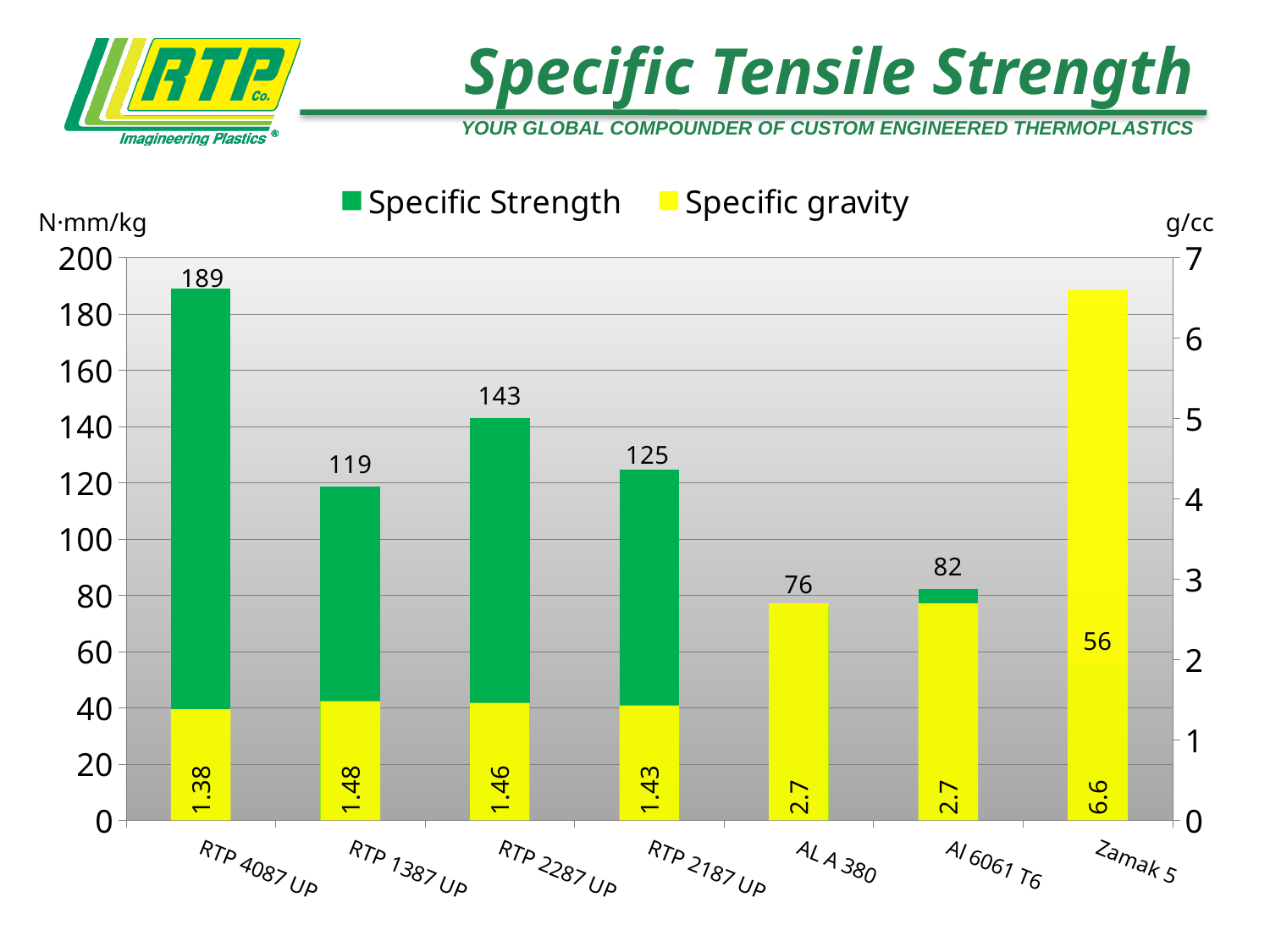
What is the Specific gravity value for Zamak 5? 6.6 What type of chart is shown on the slide? Bar chart How many categories are shown on the x axis? 7 What is the difference in Specific Strength between RTP 4087 UP and RTP 2287 UP? 46 How many series does the legend list? 2 What is the Specific gravity value for RTP 1387 UP? 1.48 Which category has the highest Specific gravity? Zamak 5 Which category has the lowest Specific Strength? Zamak 5 What is the Specific Strength value for Al 6061 T6? 82 Which category has the highest Specific Strength? RTP 4087 UP What is the Specific Strength value for RTP 4087 UP? 189 Which has a higher Specific Strength, RTP 2187 UP or RTP 1387 UP? RTP 2187 UP